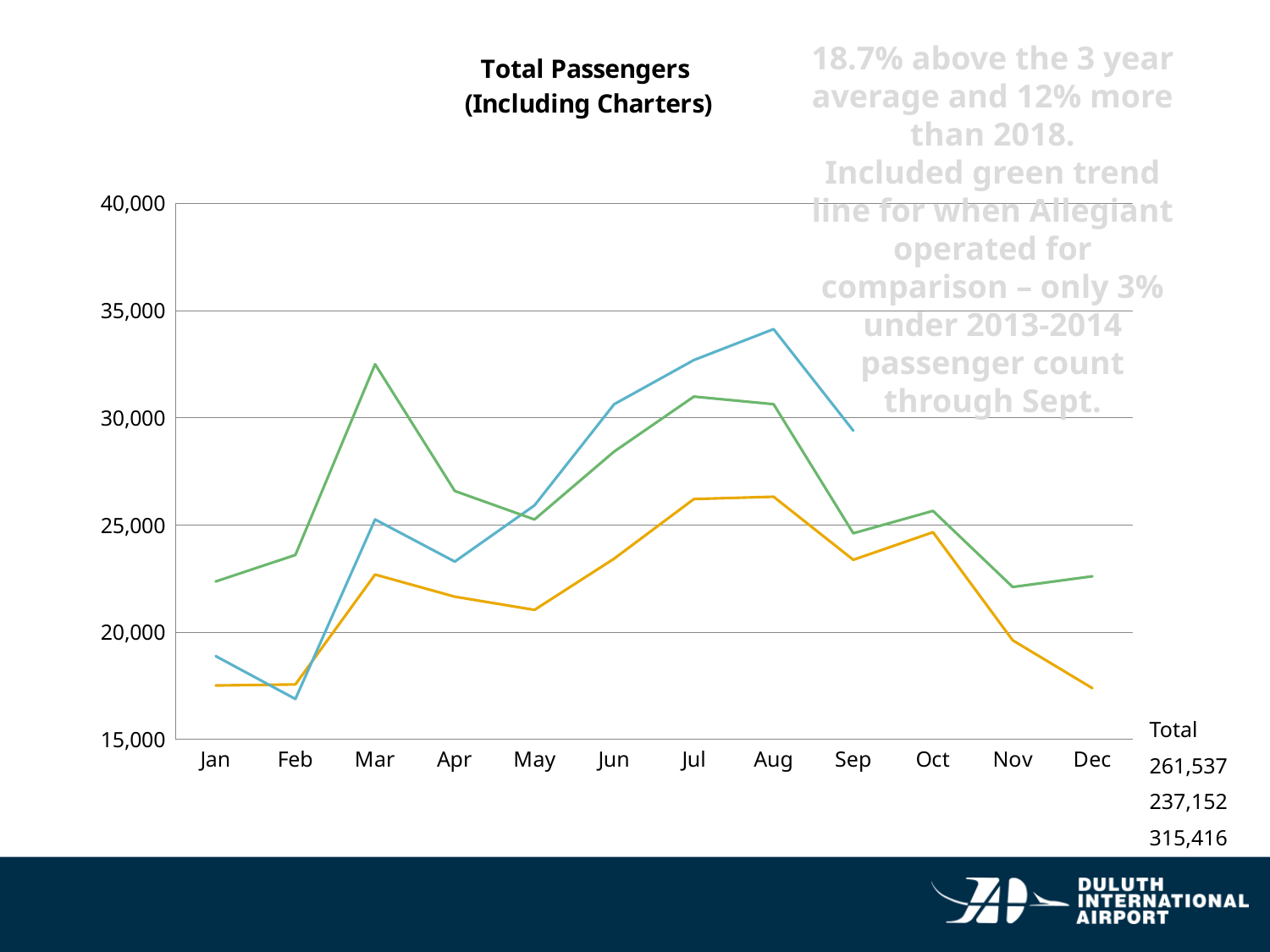
How many months are shown along the x axis of the chart? 12 In Mar, which line has the higher value, the green line or the blue line? green line What is the title of the chart? Total Passengers (Including Charters) In which month does the green line reach its highest value? Mar In which month does the blue line reach its lowest value? Feb Is the value of the green line in Nov greater or less than 25,000? less Is the value of the orange line in Dec greater or less than 20,000? less In which month does the blue line reach its highest value? Aug Does the orange line rise or fall from Aug to Dec? fall What kind of chart is shown on the slide? line chart Is the value of the blue line in Aug greater or less than 30,000? greater How many lines are plotted on the chart? 3